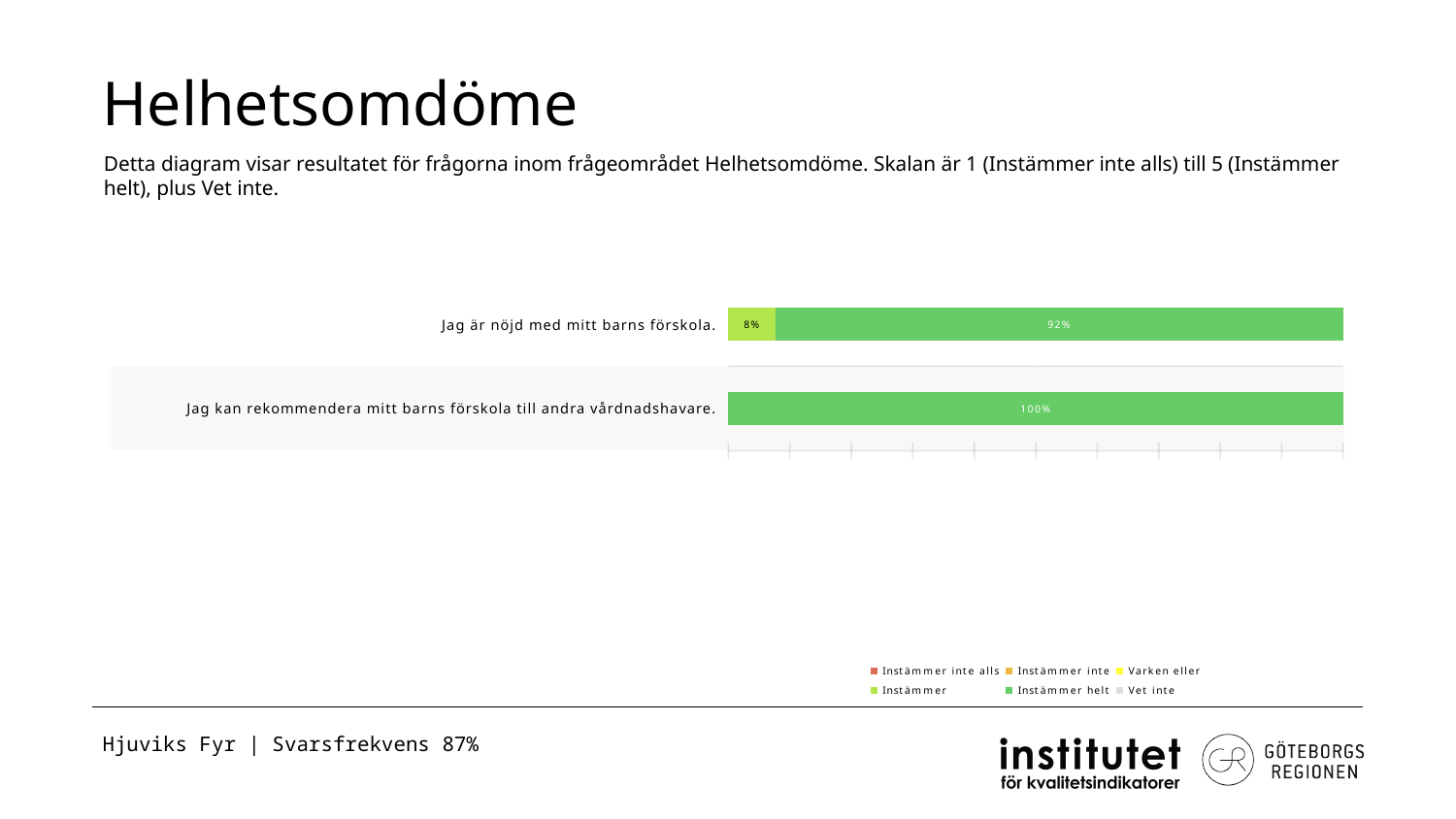
How many statements (categories) are plotted in the chart? 2 What is the 'Instämmer helt' value for 'Jag kan rekommendera mitt barns förskola till andra vårdnadshavare.'? 100% Which statement has the higher 'Instämmer helt' share? Jag kan rekommendera mitt barns förskola till andra vårdnadshavare. What is the 'Instämmer' value for 'Jag är nöjd med mitt barns förskola.'? 8% What is the total of the labelled segments in the bar for 'Jag är nöjd med mitt barns förskola.'? 100% How many series does the legend list? 6 What is the 'Instämmer helt' value for 'Jag är nöjd med mitt barns förskola.'? 92% What kind of chart is shown on the slide? Stacked bar chart What is the difference between the 'Instämmer helt' values of the two statements? 8% Which statement has the lower 'Instämmer helt' share? Jag är nöjd med mitt barns förskola. Is the 'Instämmer helt' value for 'Jag är nöjd med mitt barns förskola.' larger or smaller than its 'Instämmer' value? Larger Which legend entry is shown in the last position of the legend? Vet inte